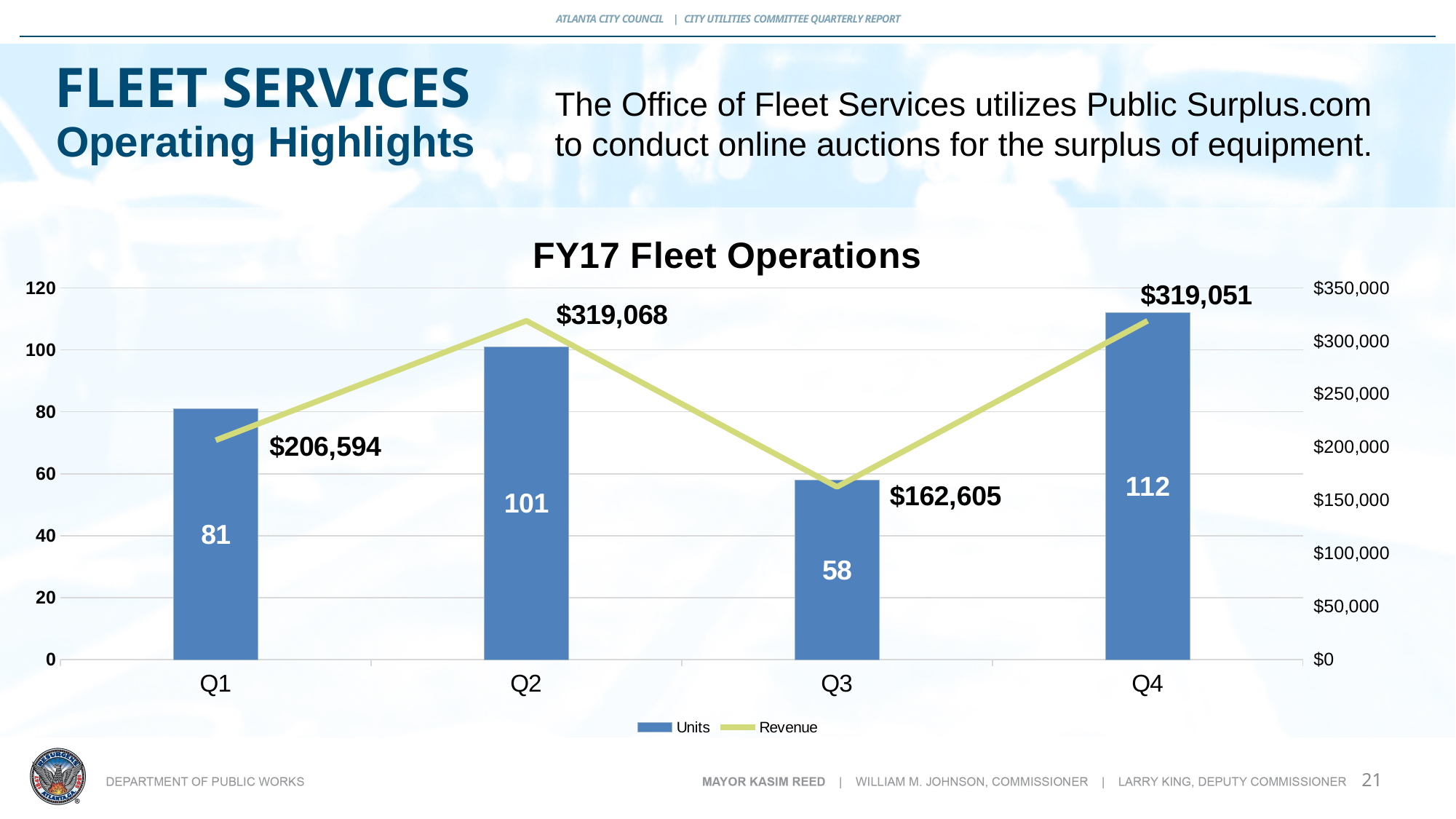
What was the revenue in Q3? $162,605 How many series does the legend list? 2 What is the difference in units between Q4 and Q3? 54 How many units were sold in Q2? 101 Which quarter had more units, Q1 or Q2? Q2 What was the revenue in Q1? $206,594 Which quarter had the lowest revenue? Q3 Which quarter had the highest number of units? Q4 What kind of chart is used to show the Units series? Bar chart Did revenue rise or fall from Q2 to Q3? Fall How many quarters are shown on the x axis? 4 What is the title of the chart? FY17 Fleet Operations